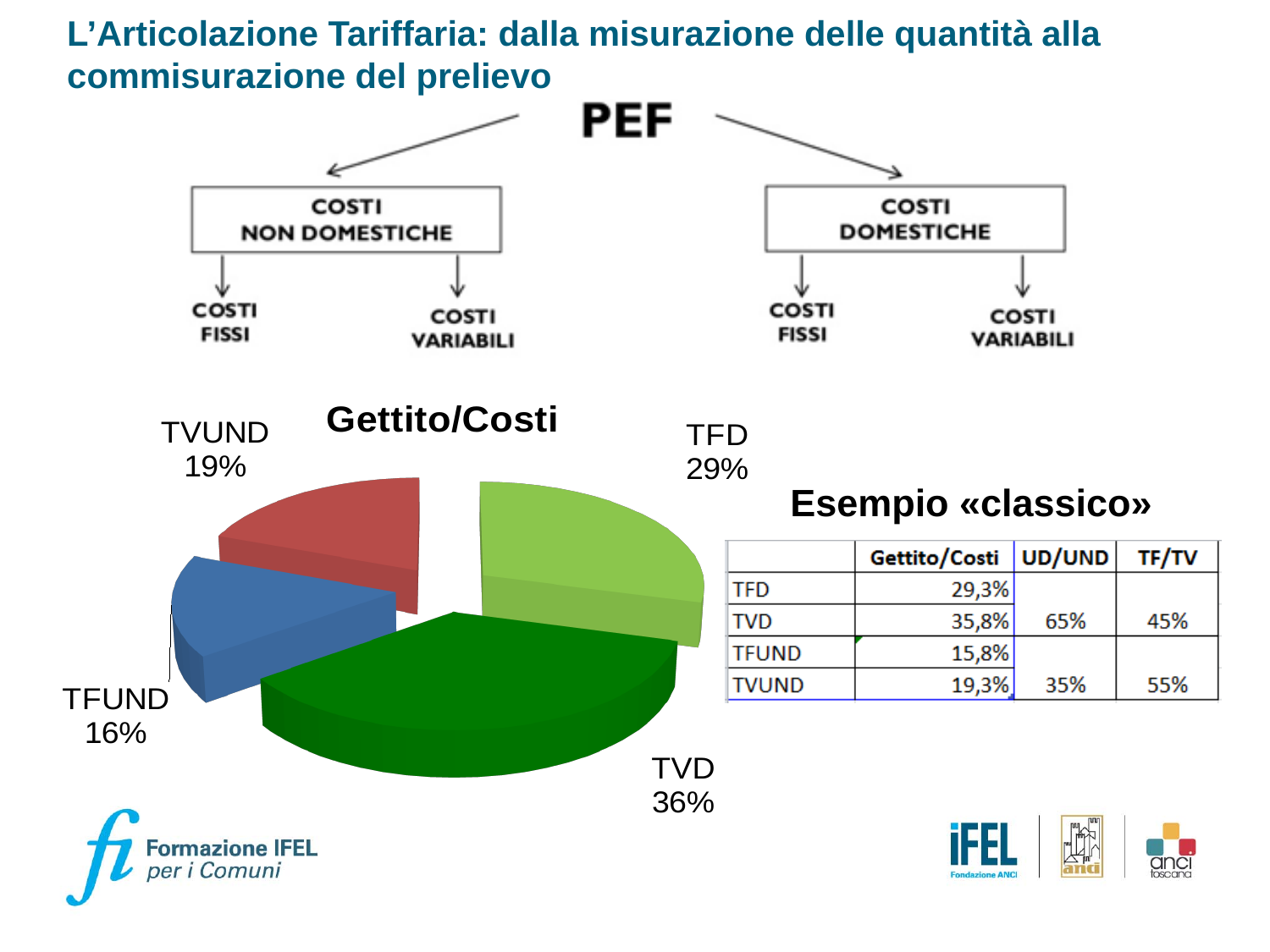
What is the title of the pie chart? Gettito/Costi How many slices does the Gettito/Costi pie chart have? 4 In the Gettito/Costi pie chart, what colour is the TVD slice? dark green In the Gettito/Costi pie chart, which is larger, TFD or TVUND? TFD What share of the Gettito/Costi pie does TVUND represent? 19% What type of chart is shown under the title "Gettito/Costi"? pie chart What share of the Gettito/Costi pie does TFD represent? 29% Which slice of the Gettito/Costi pie chart is the smallest? TFUND In the Gettito/Costi pie chart, what is the difference between the TVD share and the TFD share? 7% What share of the Gettito/Costi pie does TVD represent? 36% Which slice of the Gettito/Costi pie chart is the largest? TVD